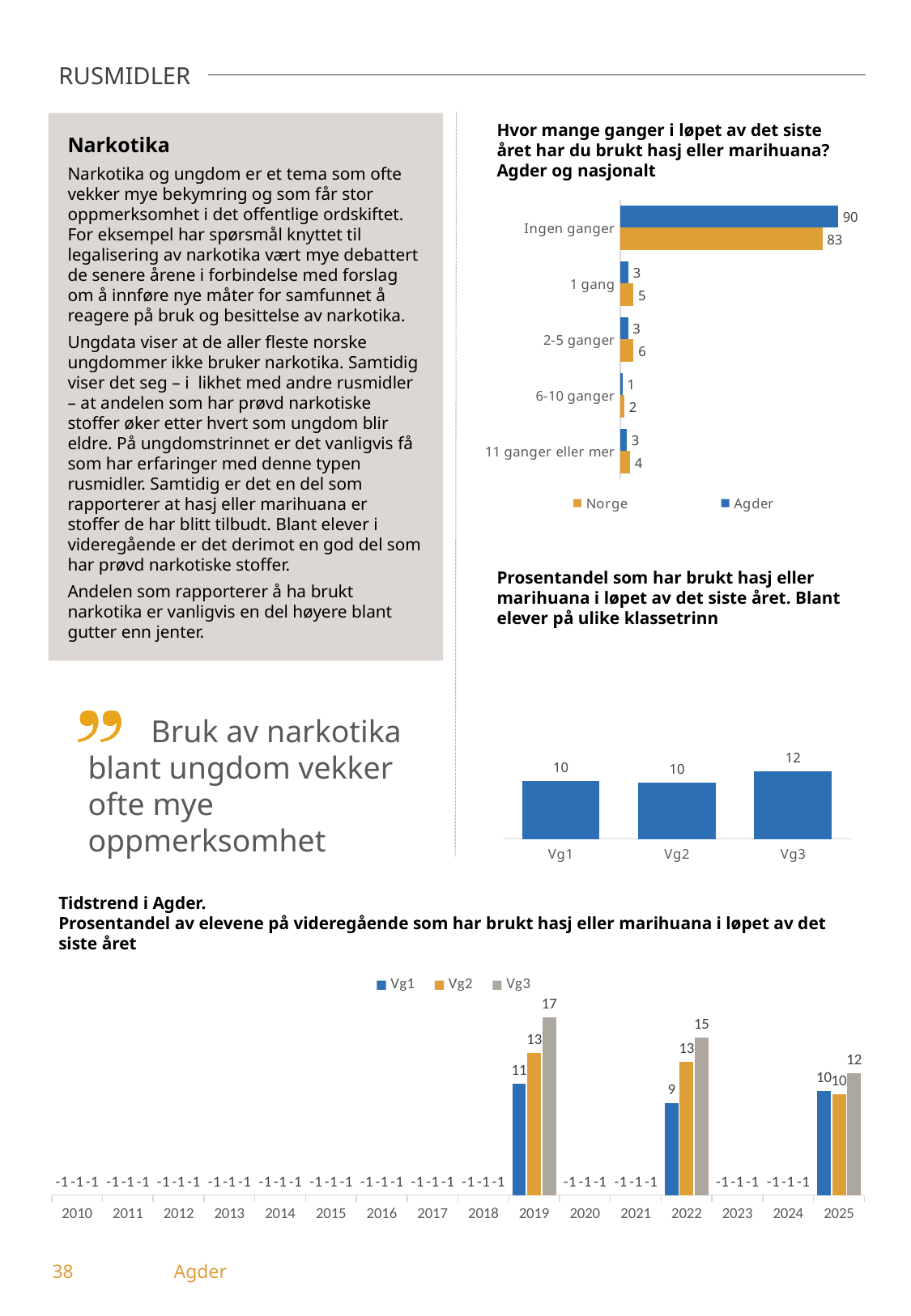
In the chart 'Hvor mange ganger i løpet av det siste året har du brukt hasj eller marihuana?', how many categories are shown? 5 In the chart 'Hvor mange ganger i løpet av det siste året har du brukt hasj eller marihuana?', what is the value for Norge in the '2-5 ganger' category? 6 In the chart 'Tidstrend i Agder', which is larger in 2022: the value for Vg1 or the value for Vg2? Vg2 In the chart 'Tidstrend i Agder', what is the value for Vg3 in 2019? 17 What kind of chart is 'Prosentandel som har brukt hasj eller marihuana i løpet av det siste året. Blant elever på ulike klassetrinn'? Bar chart In the chart 'Hvor mange ganger i løpet av det siste året har du brukt hasj eller marihuana?', what is the difference between the Agder and Norge values for 'Ingen ganger'? 7 In the chart 'Prosentandel som har brukt hasj eller marihuana i løpet av det siste året. Blant elever på ulike klassetrinn', which class level has the highest value? Vg3 In the chart 'Hvor mange ganger i løpet av det siste året har du brukt hasj eller marihuana?', what is the value for Agder in the 'Ingen ganger' category? 90 In the chart 'Tidstrend i Agder', what is the difference between the Vg3 values for 2019 and 2025? 5 In the chart 'Hvor mange ganger i løpet av det siste året har du brukt hasj eller marihuana?', how many series does the legend list? 2 In the chart 'Hvor mange ganger i løpet av det siste året har du brukt hasj eller marihuana?', which category has the lowest value for Agder? 6-10 ganger In the chart 'Prosentandel som har brukt hasj eller marihuana i løpet av det siste året. Blant elever på ulike klassetrinn', what is the value for Vg3? 12